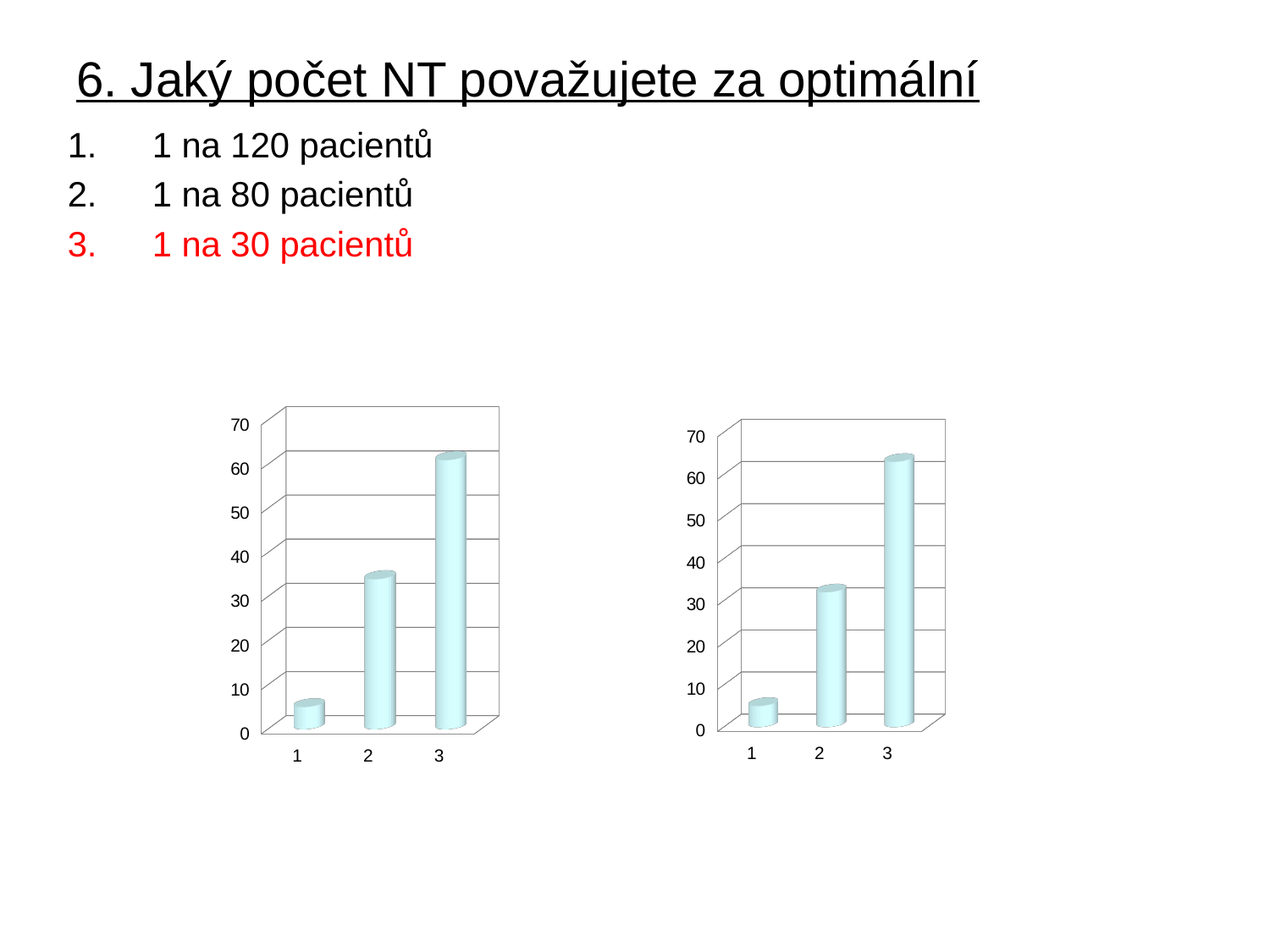
How many categories are shown on the x axis of the chart on the right of the slide? 3 In the chart on the right of the slide, which is larger, the value for category 2 or the value for category 3? 3 In the chart on the left of the slide, which category has the highest bar? 3 In the chart on the left of the slide, which category has the lowest bar? 1 In the chart on the left of the slide, is the value for category 1 greater or less than 10? less In the chart on the right of the slide, which category has the lowest bar? 1 In the chart on the left of the slide, is the value for category 3 greater or less than 50? greater In the chart on the right of the slide, is the value for category 2 greater or less than 20? greater In the chart on the left of the slide, do the values rise or fall from category 1 to category 3? rise What kind of chart is the chart on the left of the slide? bar chart In the chart on the right of the slide, which category has the highest bar? 3